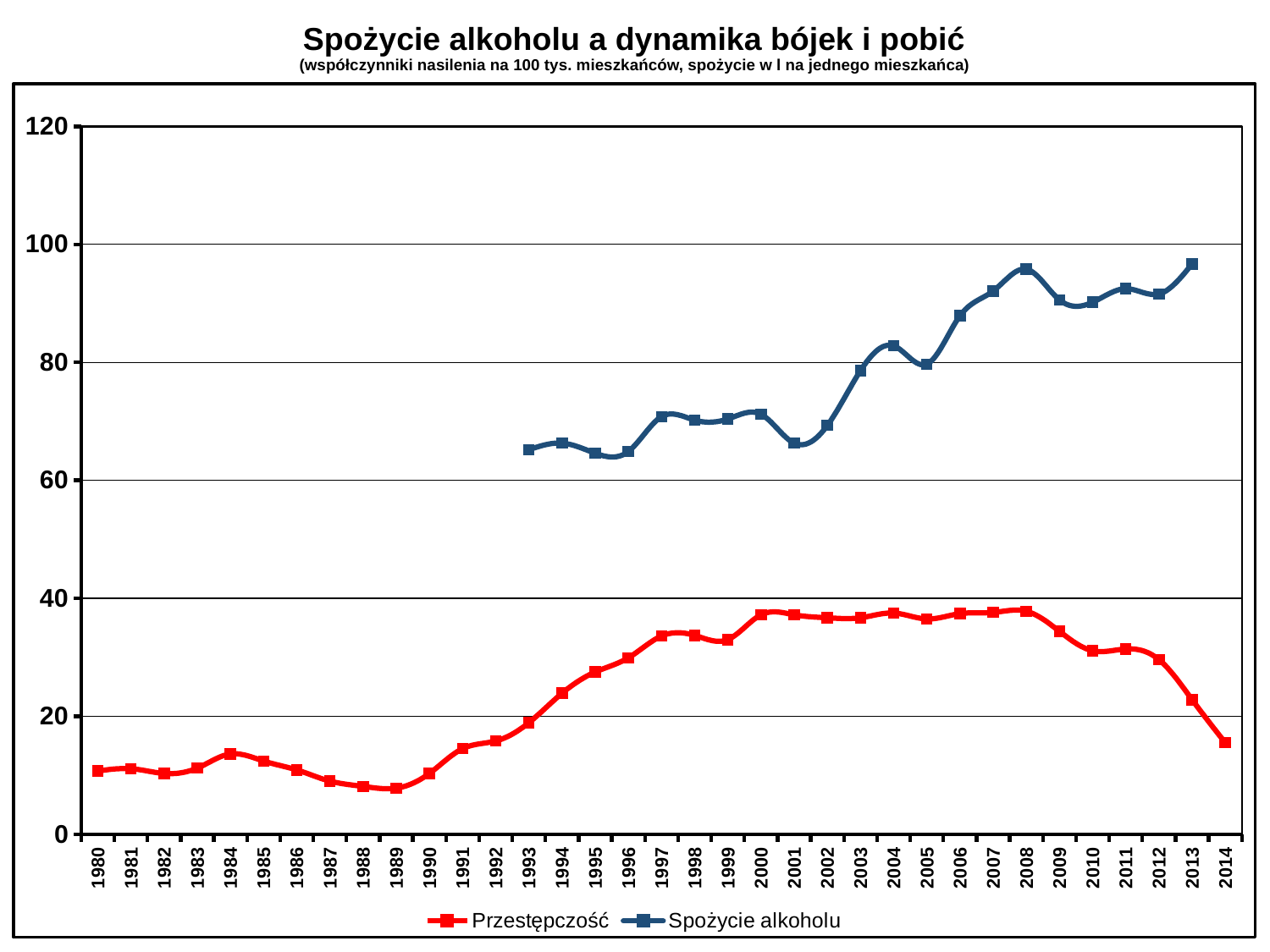
Is the value for Przestępczość in 2000 greater or less than 40? less Which is larger for Przestępczość: the value in 1984 or the value in 1989? 1984 Is the value for Przestępczość in 2014 greater or less than 20? less Is the value for Spożycie alkoholu in 2008 greater or less than 80? greater How many years are shown on the x axis? 35 How many series does the legend list? 2 Which series is drawn in red? Przestępczość Which is larger for Spożycie alkoholu: the value in 2001 or the value in 2003? 2003 What kind of chart is shown on the slide? line chart Does the Przestępczość line rise or fall between 2008 and 2014? fall